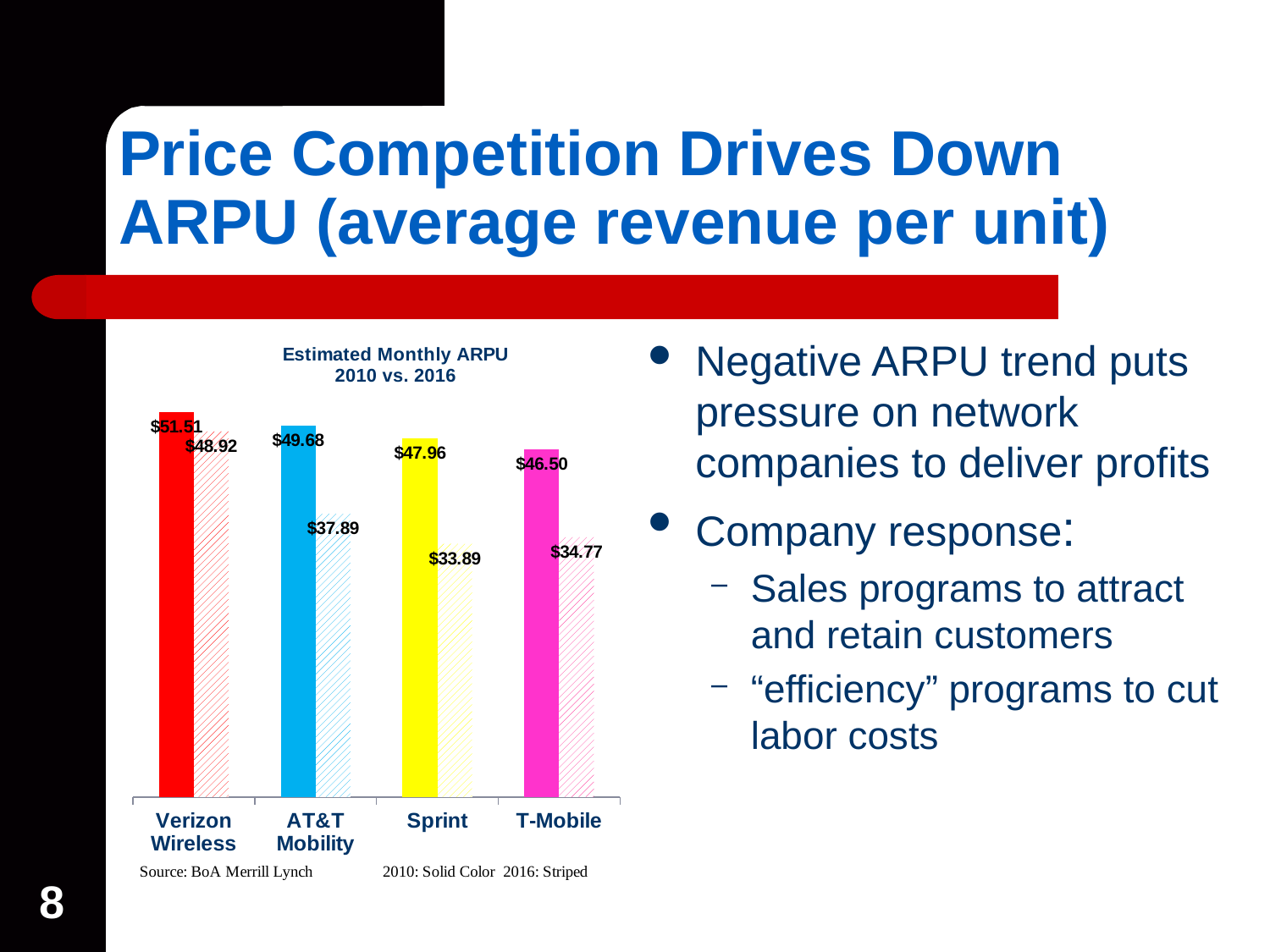
Which carrier has the lowest estimated monthly ARPU in 2016? Sprint By how much did AT&T Mobility's estimated monthly ARPU fall from 2010 to 2016? $11.79 Which carrier has the highest estimated monthly ARPU in 2010? Verizon Wireless What is the estimated monthly ARPU for Verizon Wireless in 2010? $51.51 How many carriers are shown on the chart? 4 What is the estimated monthly ARPU for T-Mobile in 2010? $46.50 Which is larger: T-Mobile's 2016 ARPU or Sprint's 2016 ARPU? T-Mobile's 2016 ARPU What is the estimated monthly ARPU for AT&T Mobility in 2016? $37.89 According to the chart note, what do the striped bars represent? 2016 What is the difference between Verizon Wireless's 2010 and 2016 estimated monthly ARPU? $2.59 What kind of chart is used to show the estimated monthly ARPU? Bar chart What is the estimated monthly ARPU for Sprint in 2016? $33.89